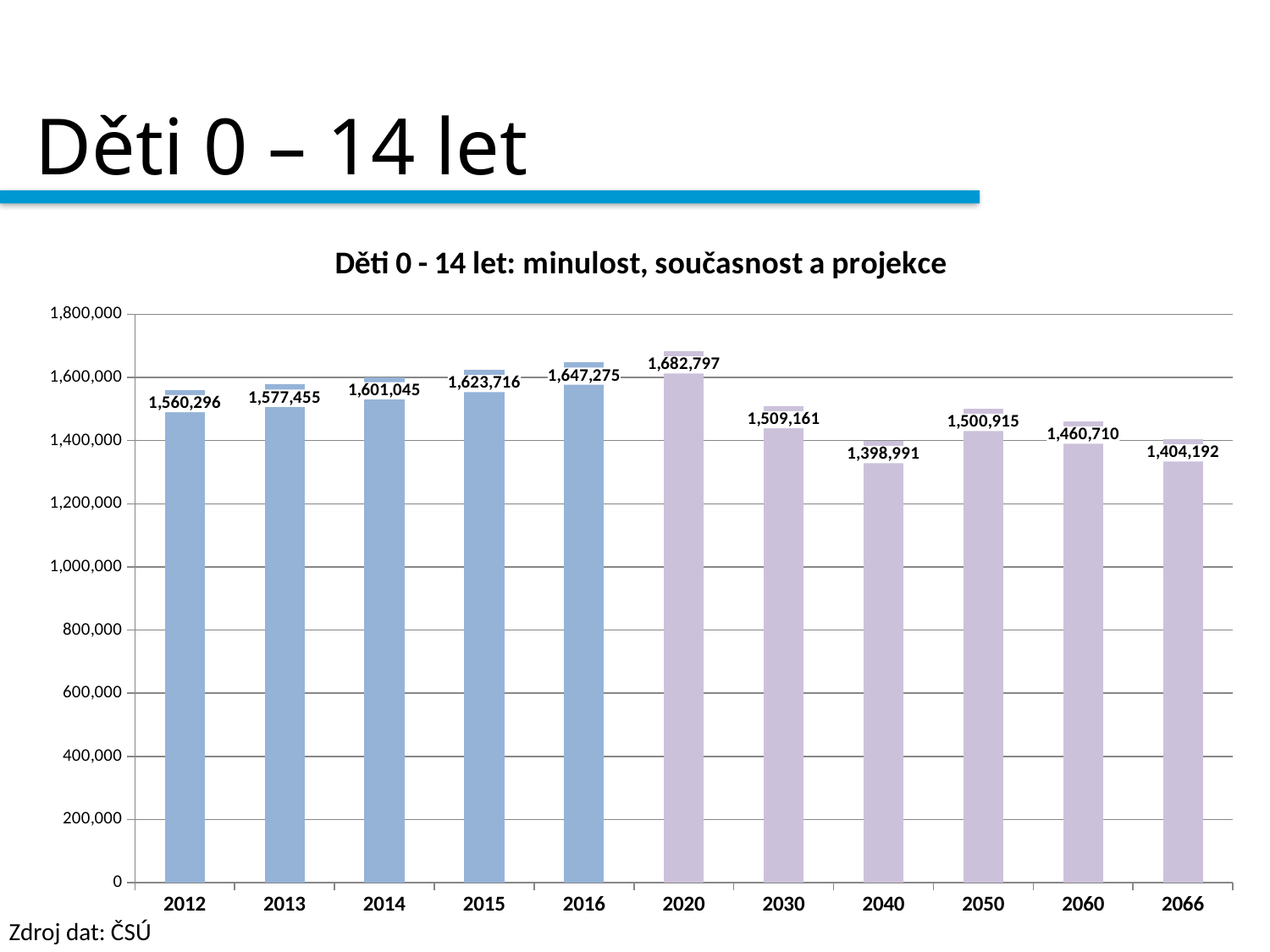
Which year has the highest value? 2020 Which is larger, the value for 2050 or the value for 2060? 2050 What is the difference between the values for 2016 and 2012? 86,979 Do the values rise or fall from 2012 to 2016? rise Is the value for 2030 greater or less than 1,600,000? less How many years are shown on the x axis? 11 What is the value for 2012? 1,560,296 What is the value for 2040? 1,398,991 What is the value for 2016? 1,647,275 What kind of chart is this? bar chart What is the difference between the values for 2020 and 2016? 35,522 Which year has the lowest value? 2040